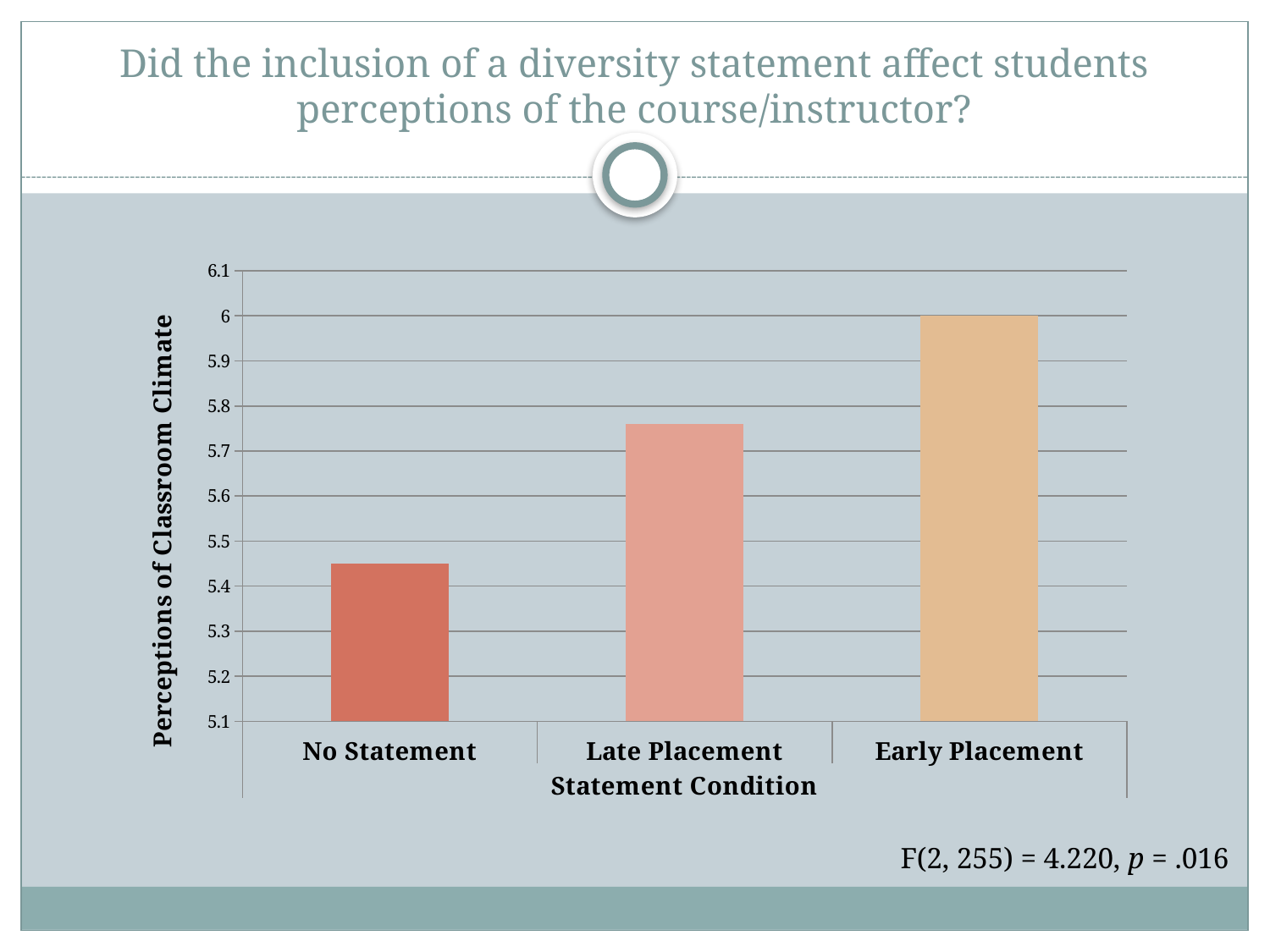
Which statement condition has the lowest perception of classroom climate? No Statement Is the value for Late Placement greater or less than 5.7? greater Which statement condition has the highest perception of classroom climate? Early Placement What is the label of the y axis? Perceptions of Classroom Climate Do the values rise or fall moving from No Statement to Early Placement along the x axis? rise Which is larger, the value for Late Placement or the value for No Statement? Late Placement Is the value for No Statement greater or less than 5.4? greater Is the value for Late Placement greater or less than 5.8? less How many statement conditions are shown on the x axis? 3 What kind of chart is shown on the slide? bar chart What is the label of the x axis? Statement Condition